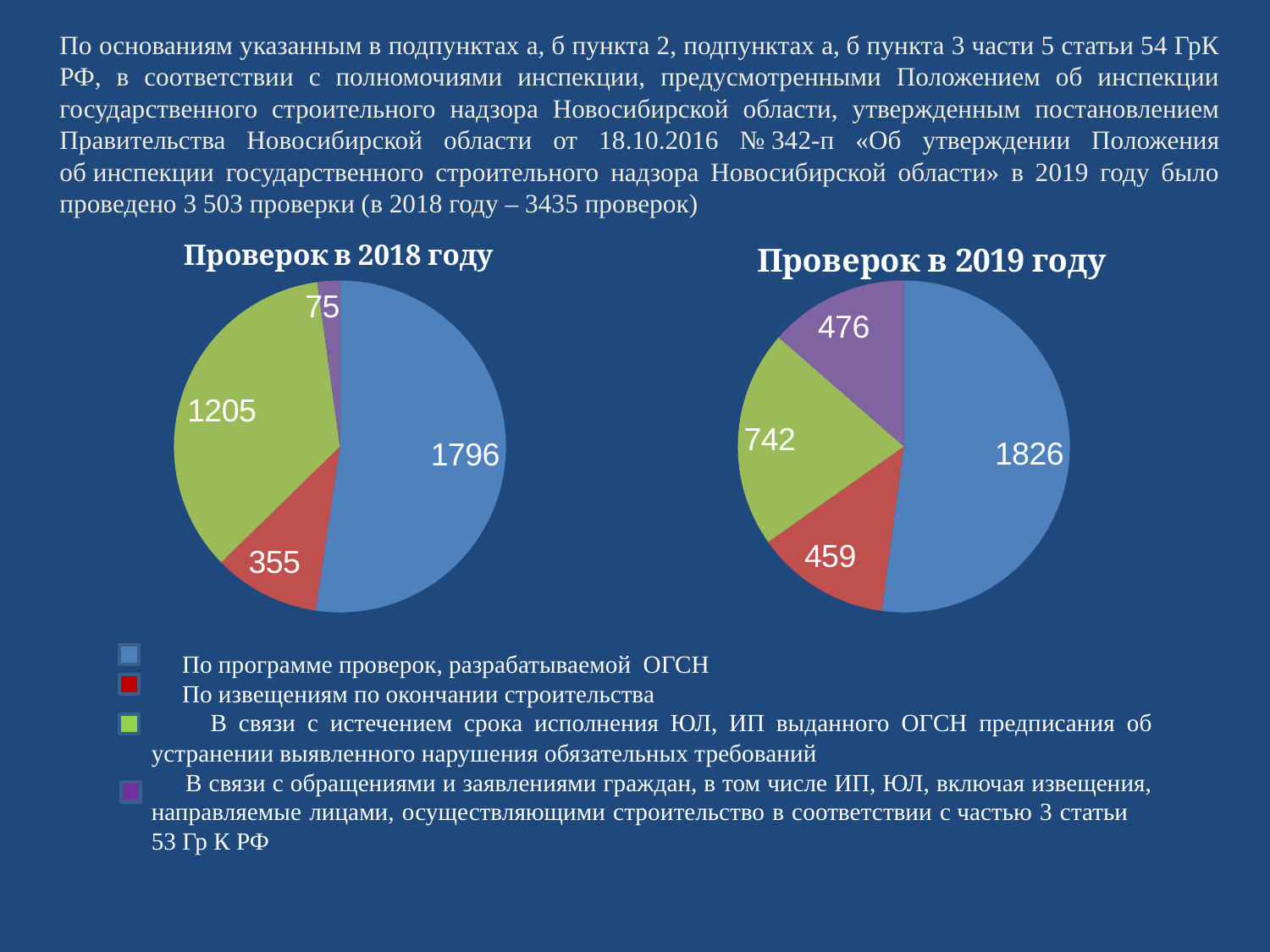
In the "Проверок в 2018 году" chart, what is the value for "По извещениям по окончании строительства" (red slice)? 355 In the "Проверок в 2019 году" chart, what is the value for "По программе проверок, разрабатываемой ОГСН" (blue slice)? 1826 What is the difference between the green slice values in the 2018 chart (1205) and the 2019 chart (742)? 463 In the "Проверок в 2019 году" chart, which category has the highest value? По программе проверок, разрабатываемой ОГСН In the "Проверок в 2018 году" chart, what is the value of the largest slice? 1796 In the "Проверок в 2019 году" chart, what is the value of the purple slice? 476 What type of chart is used for "Проверок в 2018 году"? Pie chart How many categories does the legend below the charts list? 4 In the "Проверок в 2019 году" chart, what is the value of the green slice? 742 How many slices does the "Проверок в 2019 году" pie chart have? 4 Which is larger: the purple slice in the 2018 chart or the purple slice in the 2019 chart? The 2019 chart (476) In the "Проверок в 2018 году" chart, which slice is the smallest? 75 (В связи с обращениями и заявлениями граждан)